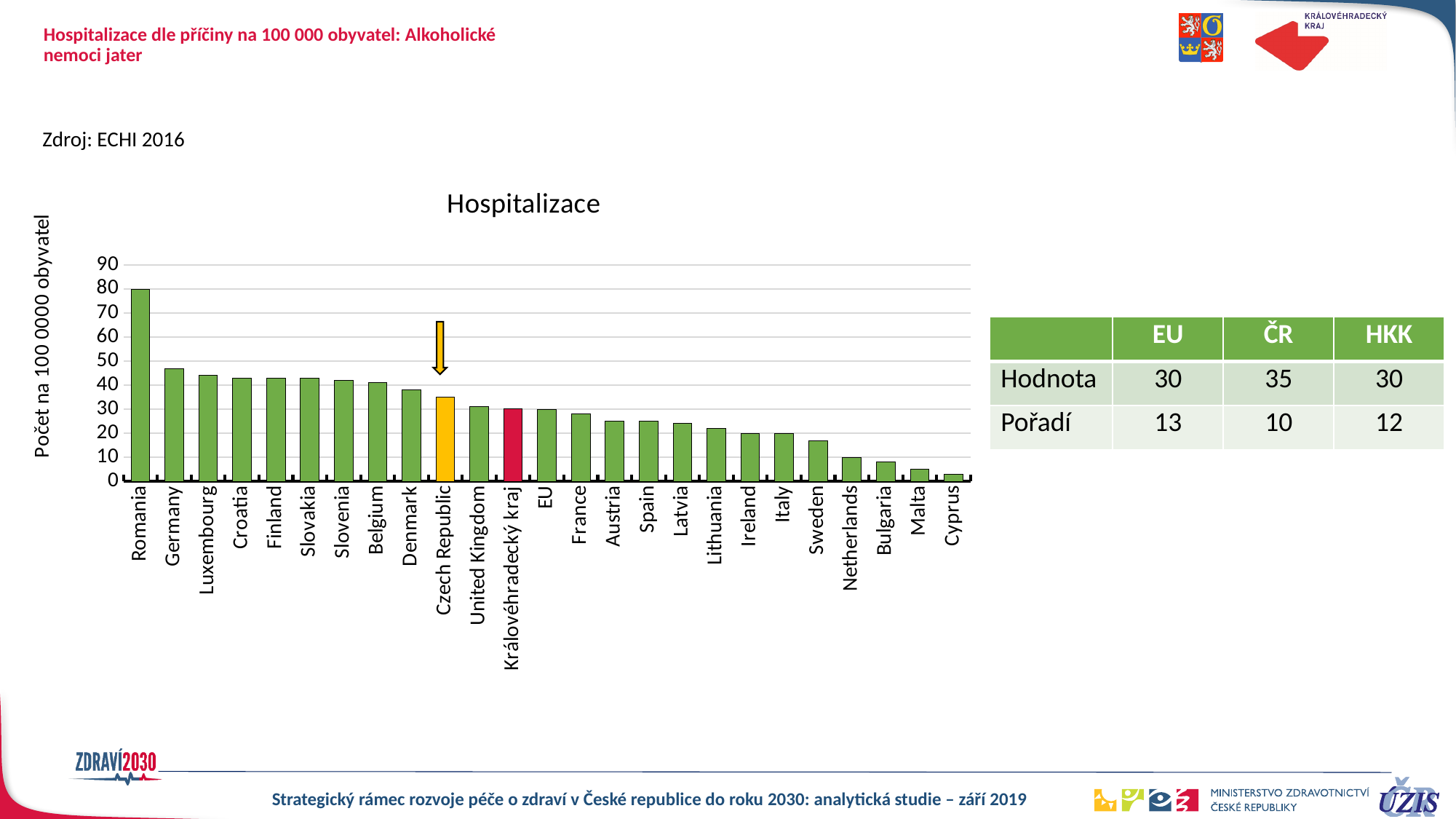
According to the table, what is the value (Hodnota) for HKK? 30 What is the difference between the ČR value and the EU value shown in the table? 5 How many categories (bars) are plotted in the chart? 25 Is the value for Romania greater or less than 70? greater Which country has the highest hospitalization rate in the chart? Romania Which category has the lowest value in the chart? Cyprus Is the value for Sweden greater or less than 20? less According to the table, what is the value (Hodnota) for ČR? 35 Which is larger, the value for Romania or the value for Germany? Romania Do the bar values rise or fall from left to right along the x axis? fall What kind of chart is shown on the slide? bar chart Is the value for Cyprus greater or less than 10? less